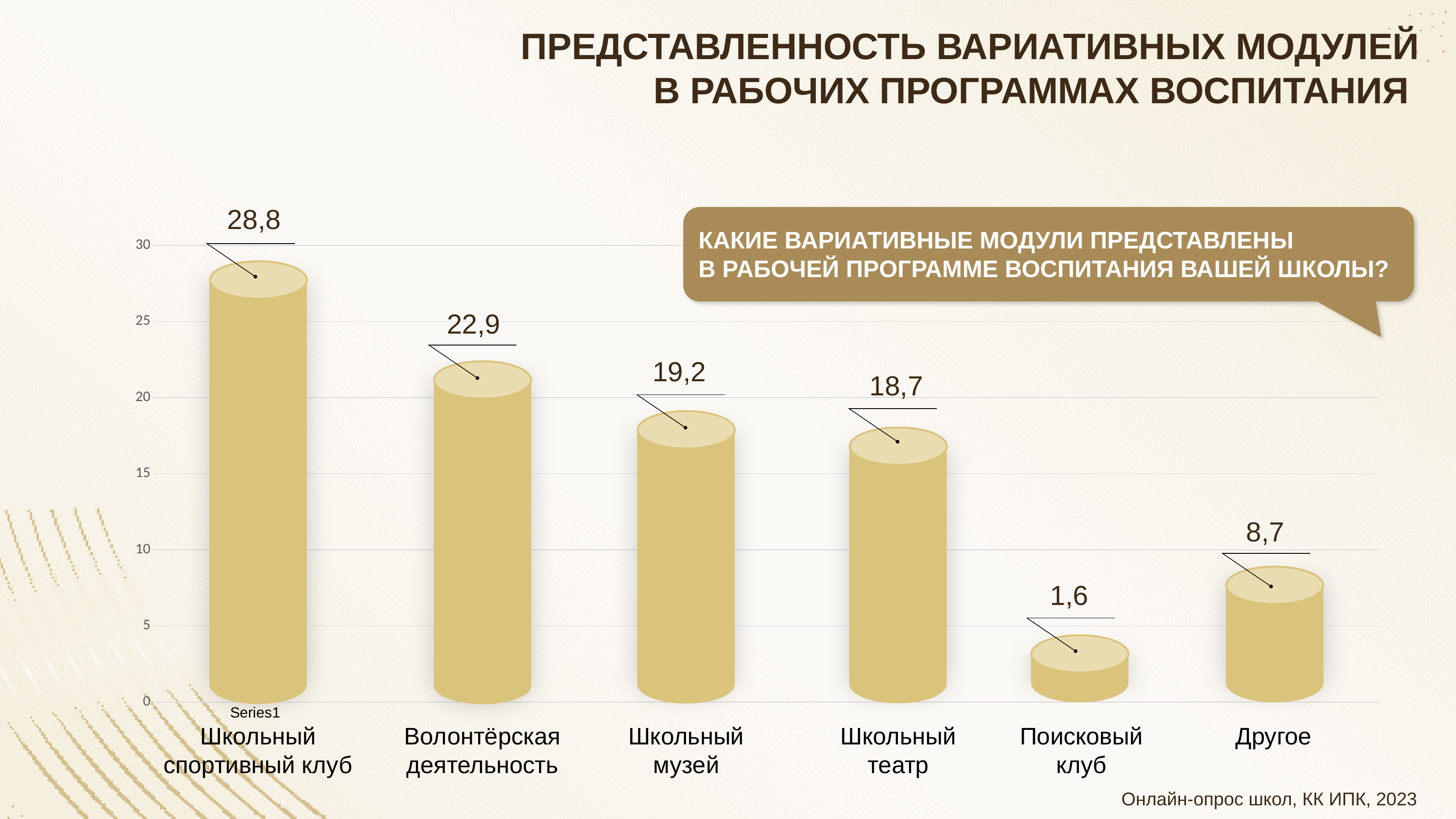
What is the value for Школьный спортивный клуб? 28,8 Is the value for Школьный театр greater or less than 20? less What is the value for Волонтёрская деятельность? 22,9 What is the value for Другое? 8,7 What is the value for Поисковый клуб? 1,6 Which category has the highest value? Школьный спортивный клуб What is the difference between the values for Школьный спортивный клуб and Волонтёрская деятельность? 5,9 Which is larger, the value for Школьный музей or the value for Школьный театр? Школьный музей Which category has the lowest value? Поисковый клуб What is the source noted at the bottom of the slide? Онлайн-опрос школ, КК ИПК, 2023 What kind of chart is shown on the slide? bar chart How many categories are shown on the chart? 6